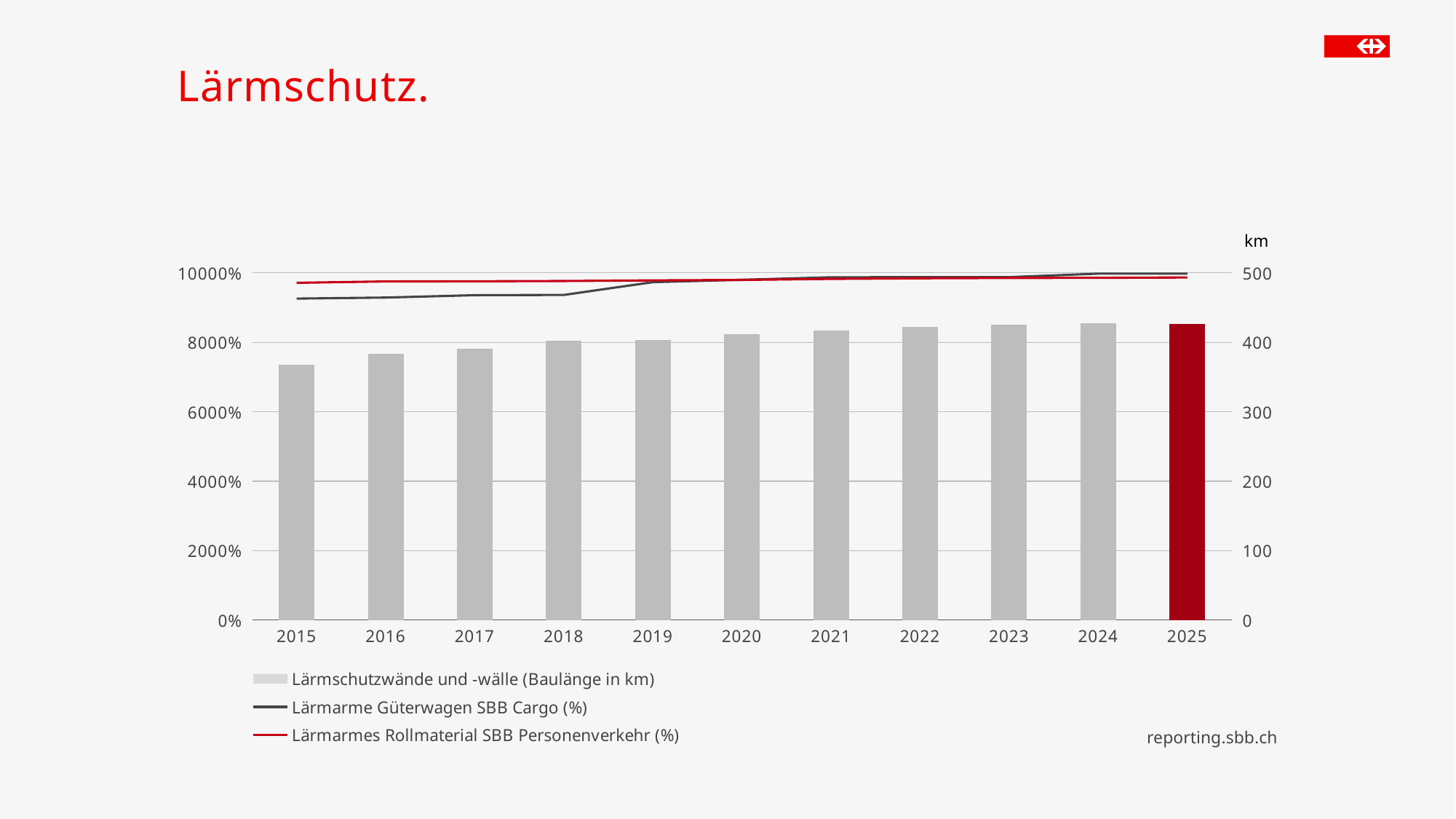
In 2025, which line is higher: Lärmarme Güterwagen SBB Cargo (%) or Lärmarmes Rollmaterial SBB Personenverkehr (%)? Lärmarme Güterwagen SBB Cargo (%) In 2015, which line is higher: Lärmarme Güterwagen SBB Cargo (%) or Lärmarmes Rollmaterial SBB Personenverkehr (%)? Lärmarmes Rollmaterial SBB Personenverkehr (%) How many years are shown on the x axis? 11 Do the bars for Lärmschutzwände und -wälle rise or fall from 2015 to 2025? Rise Is the value for Lärmarme Güterwagen SBB Cargo (%) in 2015 greater or less than 10000%? less What unit is shown on the right-hand axis of the chart? km Is the value for Lärmschutzwände und -wälle in 2015 greater or less than 400 km? less Which year has the lowest bar for Lärmschutzwände und -wälle (Baulänge in km)? 2015 What kind of chart is shown on the slide? A combined bar and line chart What is the title of the chart on the slide? Lärmschutz. Is the value for Lärmschutzwände und -wälle in 2024 greater or less than 400 km? greater How many series does the legend list? 3